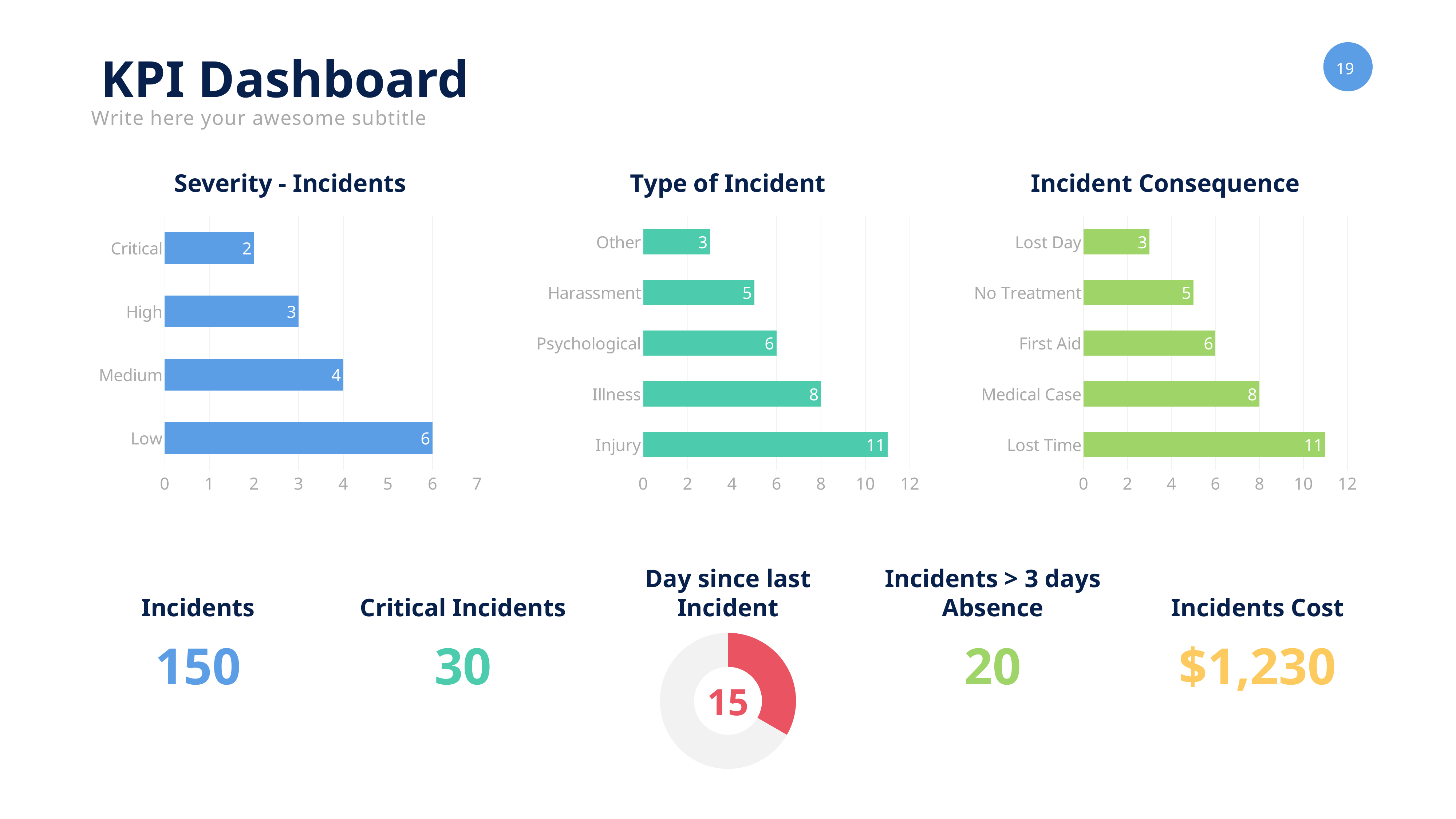
What kind of chart is the 'Severity - Incidents' chart? Bar chart In the 'Type of Incident' chart, which is larger, Illness or Psychological? Illness In the 'Incident Consequence' chart, what is the difference between Lost Time and First Aid? 5 In the 'Severity - Incidents' chart, how many categories are shown? 4 In the 'Severity - Incidents' chart, which category has the highest value? Low In the 'Incident Consequence' chart, which category has the highest value? Lost Time In the 'Incident Consequence' chart, what is the value for Medical Case? 8 In the 'Severity - Incidents' chart, what is the difference between Low and Critical? 4 In the 'Type of Incident' chart, how many categories are shown? 5 In the 'Type of Incident' chart, what is the value for Harassment? 5 In the 'Type of Incident' chart, which category has the lowest value? Other In the 'Severity - Incidents' chart, what is the value for Medium? 4